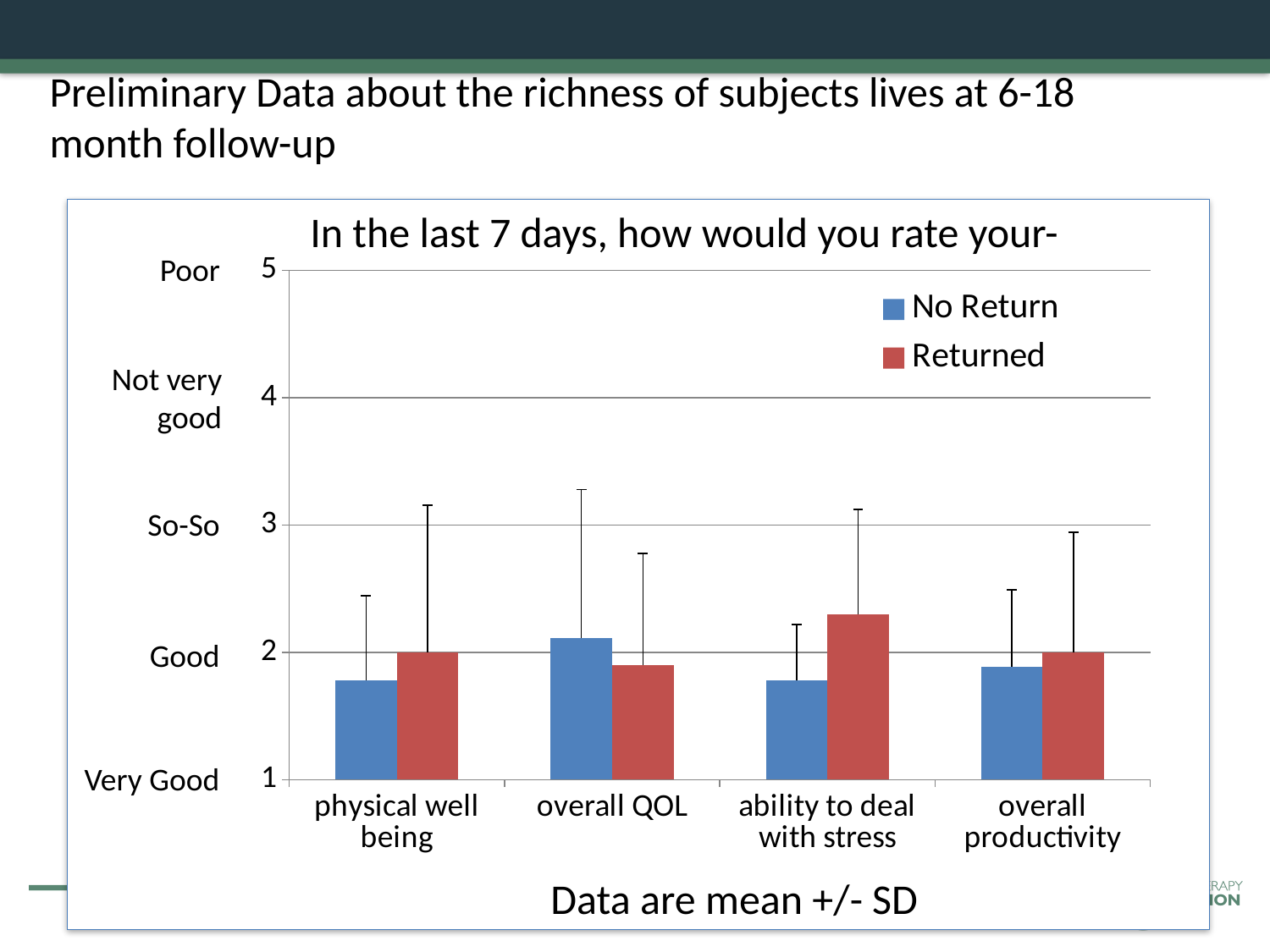
How many categories are shown on the x axis? 4 Which series is shown in red? Returned Is the No Return value for overall QOL greater or less than 3? less For overall QOL, which series has the larger value, No Return or Returned? No Return Is the No Return value for physical well being greater or less than 2? less Which category has the highest Returned value? ability to deal with stress What is the title of the chart? In the last 7 days, how would you rate your- For ability to deal with stress, which series has the larger value, No Return or Returned? Returned Is the Returned value for ability to deal with stress greater or less than 2? greater How many series does the legend list? 2 What kind of chart is shown on the slide? bar chart